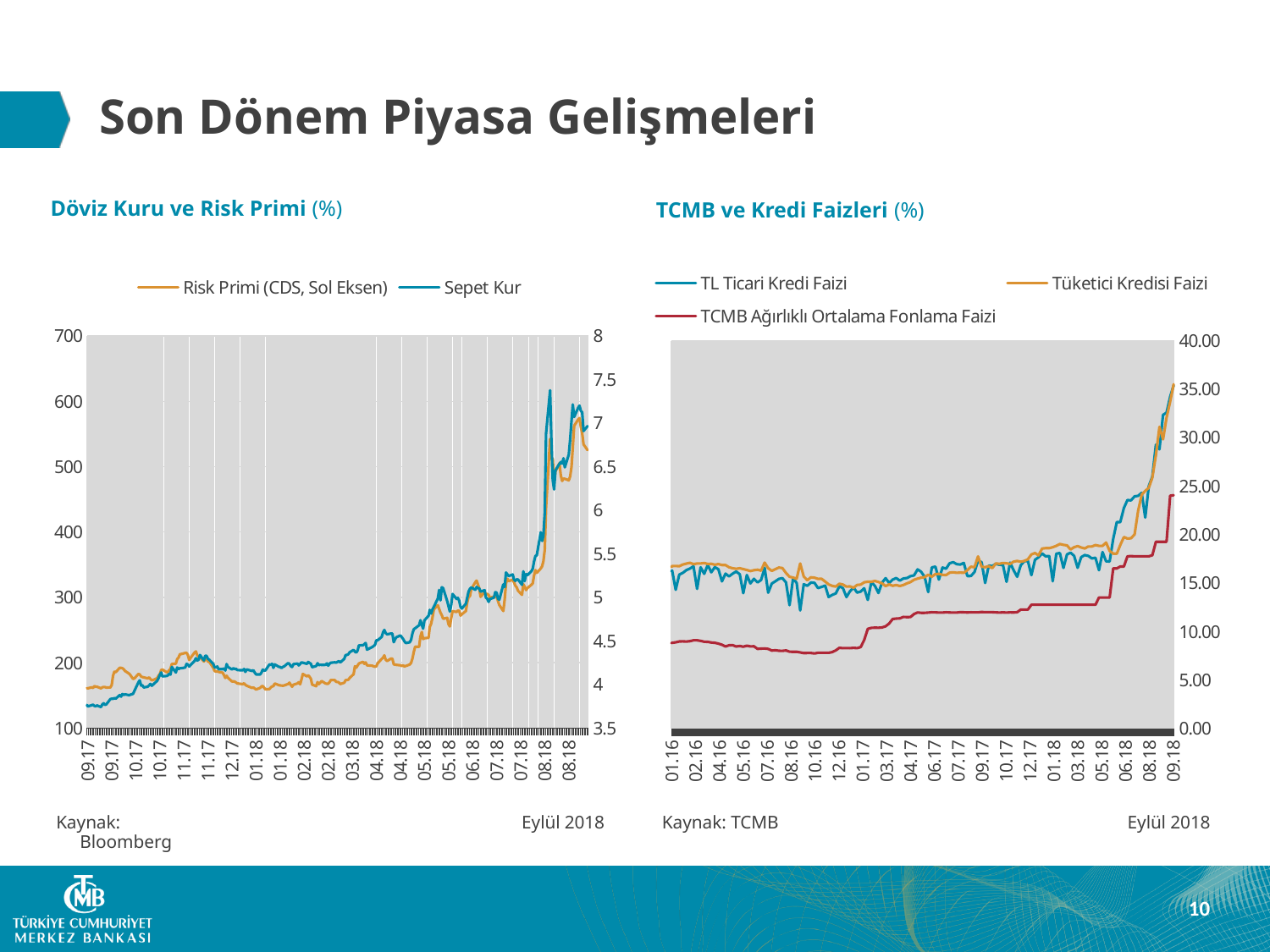
In the 'Döviz Kuru ve Risk Primi (%)' chart, which axis does the Risk Primi (CDS) series use according to the legend? Left axis (Sol Eksen) In the 'TCMB ve Kredi Faizleri (%)' chart, is the Tüketici Kredisi Faizi at 09.18 greater or less than 30.00? greater In the 'TCMB ve Kredi Faizleri (%)' chart, is the TCMB Ağırlıklı Ortalama Fonlama Faizi at 01.16 greater or less than 10.00? less In the 'Döviz Kuru ve Risk Primi (%)' chart, is the peak Risk Primi (CDS) value in 08.18 greater or less than 500? greater How many series does the legend of the 'TCMB ve Kredi Faizleri (%)' chart list? 3 How many series does the legend of the 'Döviz Kuru ve Risk Primi (%)' chart list? 2 What kind of chart is the 'Döviz Kuru ve Risk Primi (%)' chart on the left? Line chart In the 'TCMB ve Kredi Faizleri (%)' chart, which series is the lowest across the whole period? TCMB Ağırlıklı Ortalama Fonlama Faizi What is the source given for the 'TCMB ve Kredi Faizleri (%)' chart? TCMB In the 'Döviz Kuru ve Risk Primi (%)' chart, does the Sepet Kur series overall rise or fall from 09.17 to 08.18? Rise